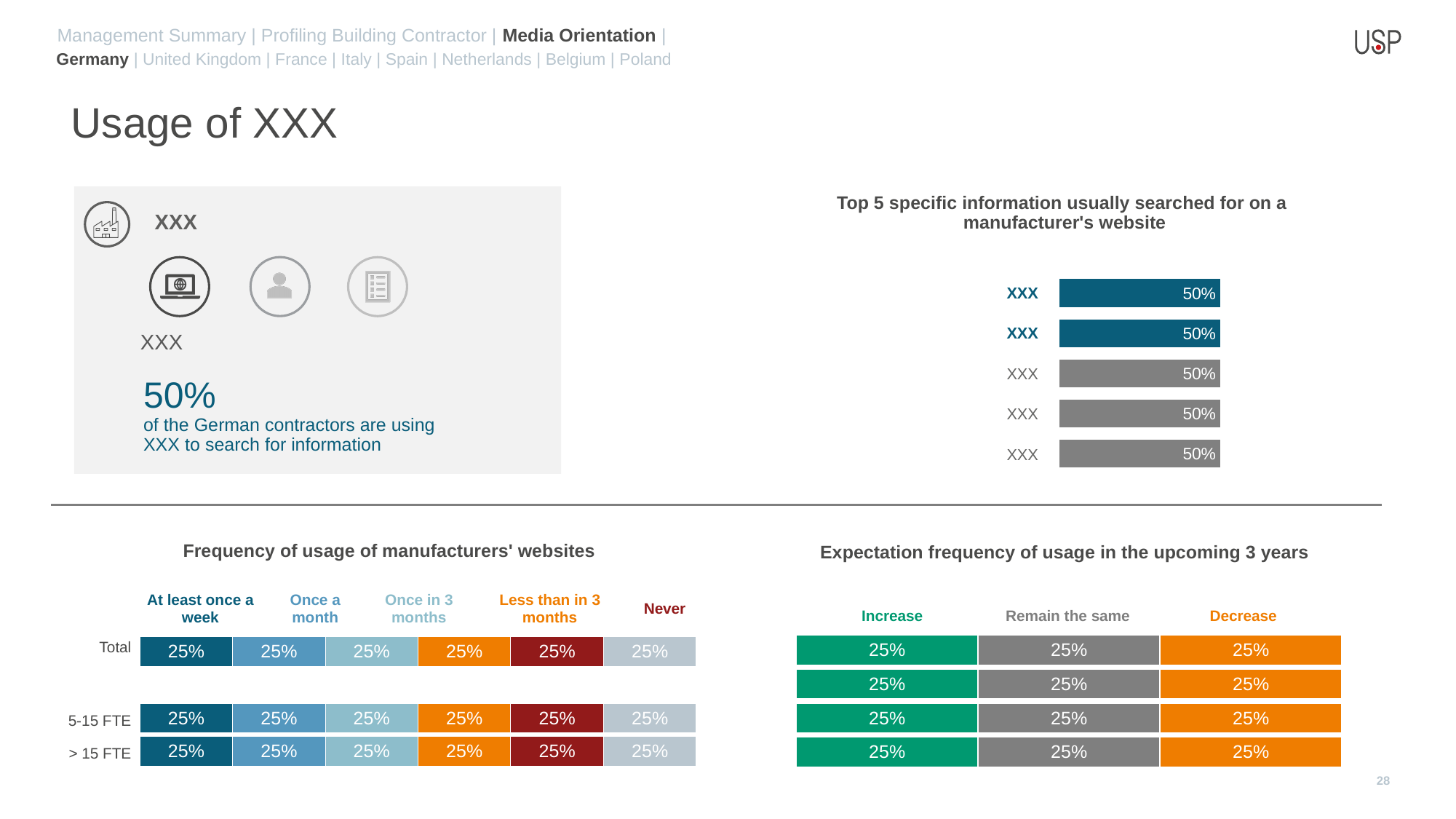
What kind of chart is 'Top 5 specific information usually searched for on a manufacturer's website'? bar chart In the chart 'Frequency of usage of manufacturers' websites', how many rows (groups) are plotted? 3 In the chart 'Expectation frequency of usage in the upcoming 3 years', how many series does the legend list? 3 In the chart 'Frequency of usage of manufacturers' websites', what is the value for 'At least once a week' in the Total row? 25% What is the title of the chart in the bottom-left of the slide? Frequency of usage of manufacturers' websites In the chart 'Expectation frequency of usage in the upcoming 3 years', what colour represents 'Increase'? green In the chart 'Expectation frequency of usage in the upcoming 3 years', what is the total of the first stacked bar (Increase + Remain the same + Decrease)? 75% In the chart 'Expectation frequency of usage in the upcoming 3 years', how many stacked bars are shown? 4 In the chart 'Frequency of usage of manufacturers' websites', what is the value for 'Never' in the > 15 FTE row? 25% In the chart 'Top 5 specific information usually searched for on a manufacturer's website', what value is shown on the first bar? 50% In the chart 'Expectation frequency of usage in the upcoming 3 years', what is the value for 'Increase' in the first row? 25% In the chart 'Top 5 specific information usually searched for on a manufacturer's website', how many bars are shown? 5